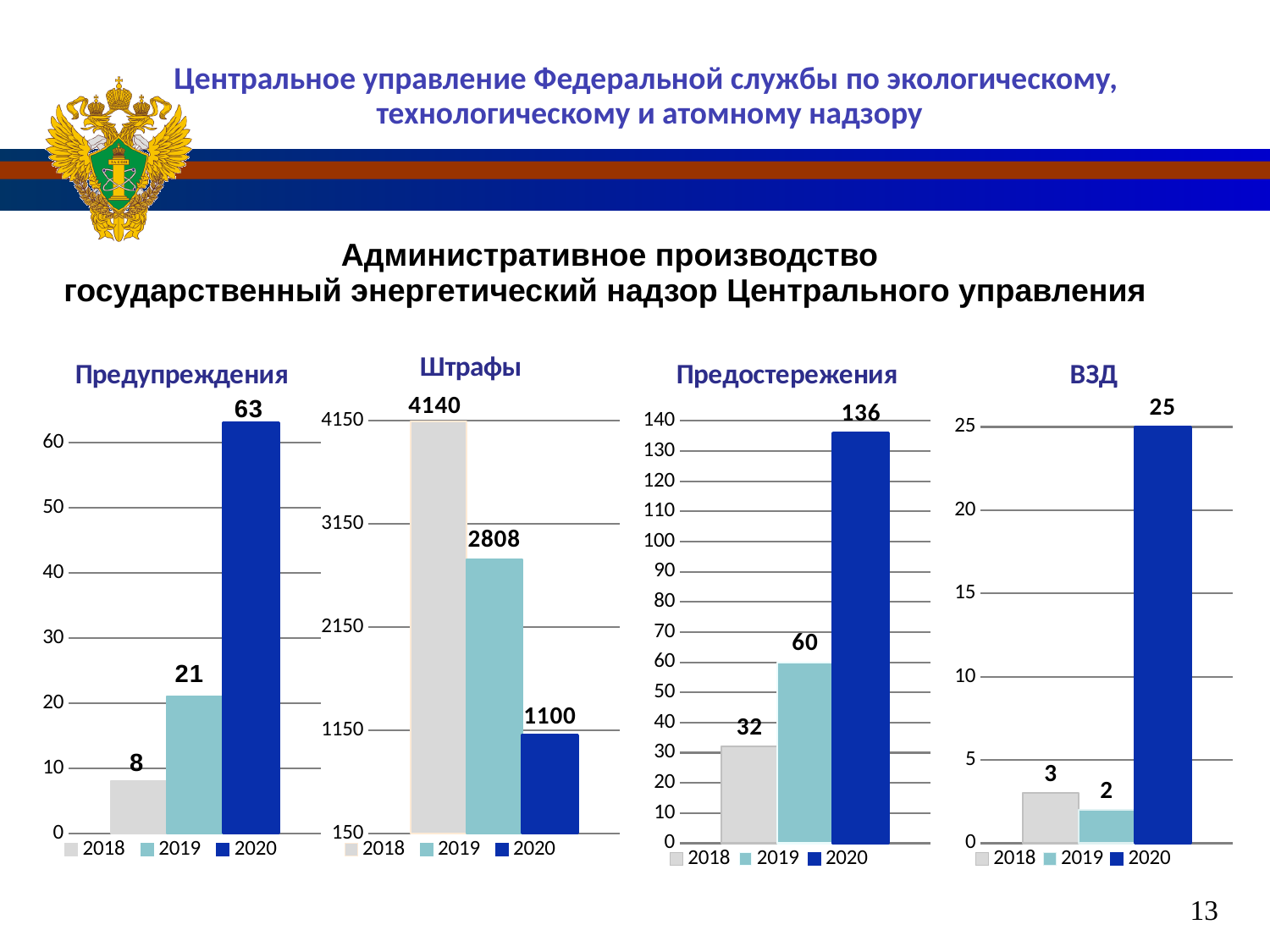
In the 'ВЗД' chart, which year has the lowest value? 2019 In the 'Предостережения' chart, what is the value for 2018? 32 How many series does the legend of the 'ВЗД' chart list? 3 In the 'Штрафы' chart, what is the difference between the 2018 and 2020 values? 3040 In the 'Штрафы' chart, which year has the highest value? 2018 In the 'Предостережения' chart, what is the difference between the 2020 and 2019 values? 76 In the 'Предупреждения' chart, which is larger, the value for 2018 or the value for 2019? 2019 What kind of chart is the 'Предостережения' chart? bar chart In the 'Предупреждения' chart, what is the value for 2020? 63 In the 'Предупреждения' chart, do the values rise or fall from 2018 to 2020? rise In the 'Штрафы' chart, what is the value for 2019? 2808 In the 'Штрафы' chart, do the values rise or fall from 2018 to 2020? fall